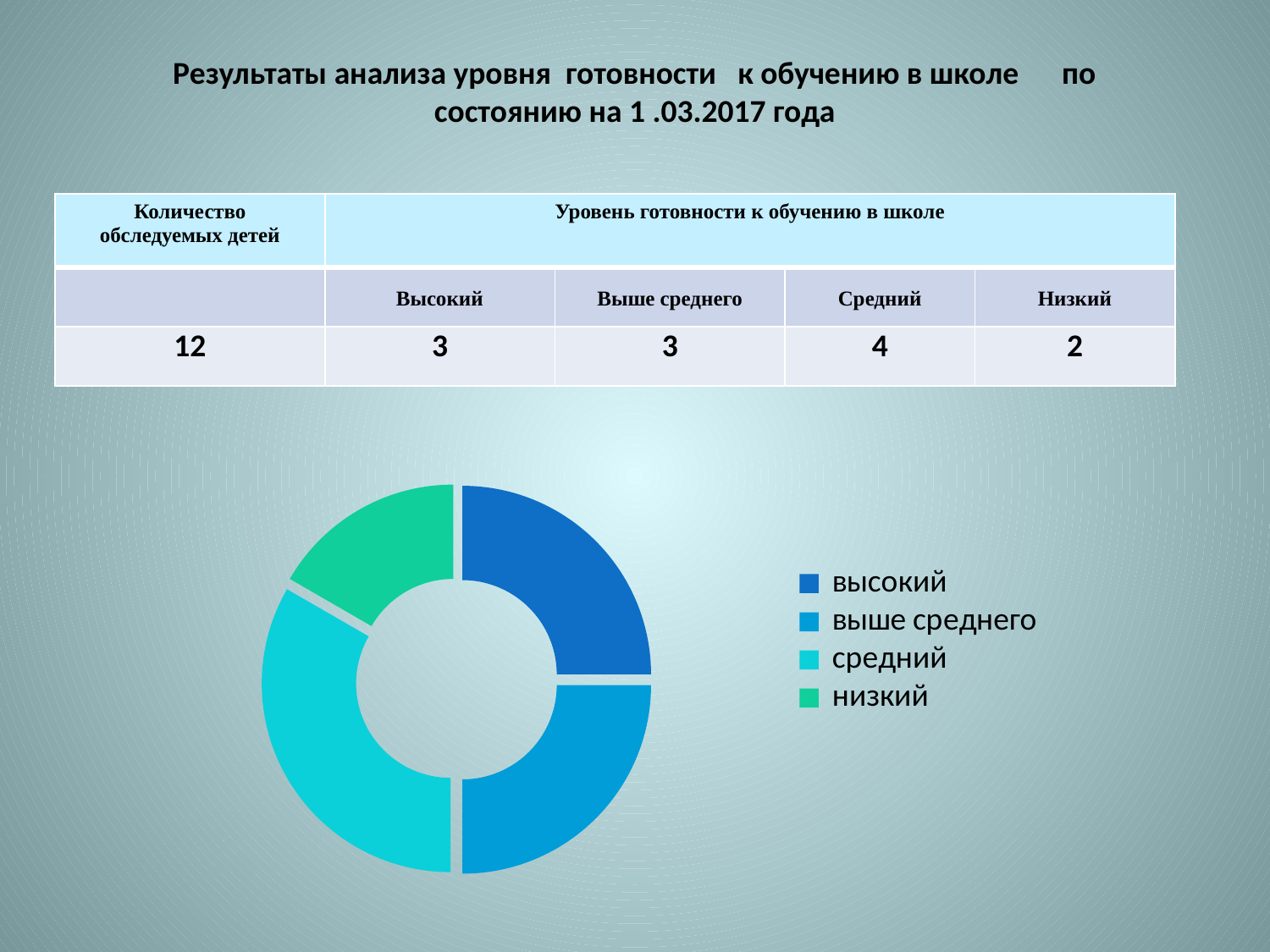
According to the table on the slide, how many children are at the средний level? 4 How many entries does the chart legend list? 4 How many slices does the doughnut chart have? 4 Which slice is larger, средний or низкий? средний Which category has the smallest slice in the doughnut chart? низкий Which category has the largest slice in the doughnut chart? средний According to the table on the slide, how many children are at the низкий level? 2 What kind of chart is shown on the slide? doughnut (pie) chart What is the total number of children examined, as shown in the table? 12 What colour is the высокий slice in the doughnut chart? dark blue What is the difference between the number of children at the средний level and at the низкий level? 2 Which slice is larger, высокий or низкий? высокий